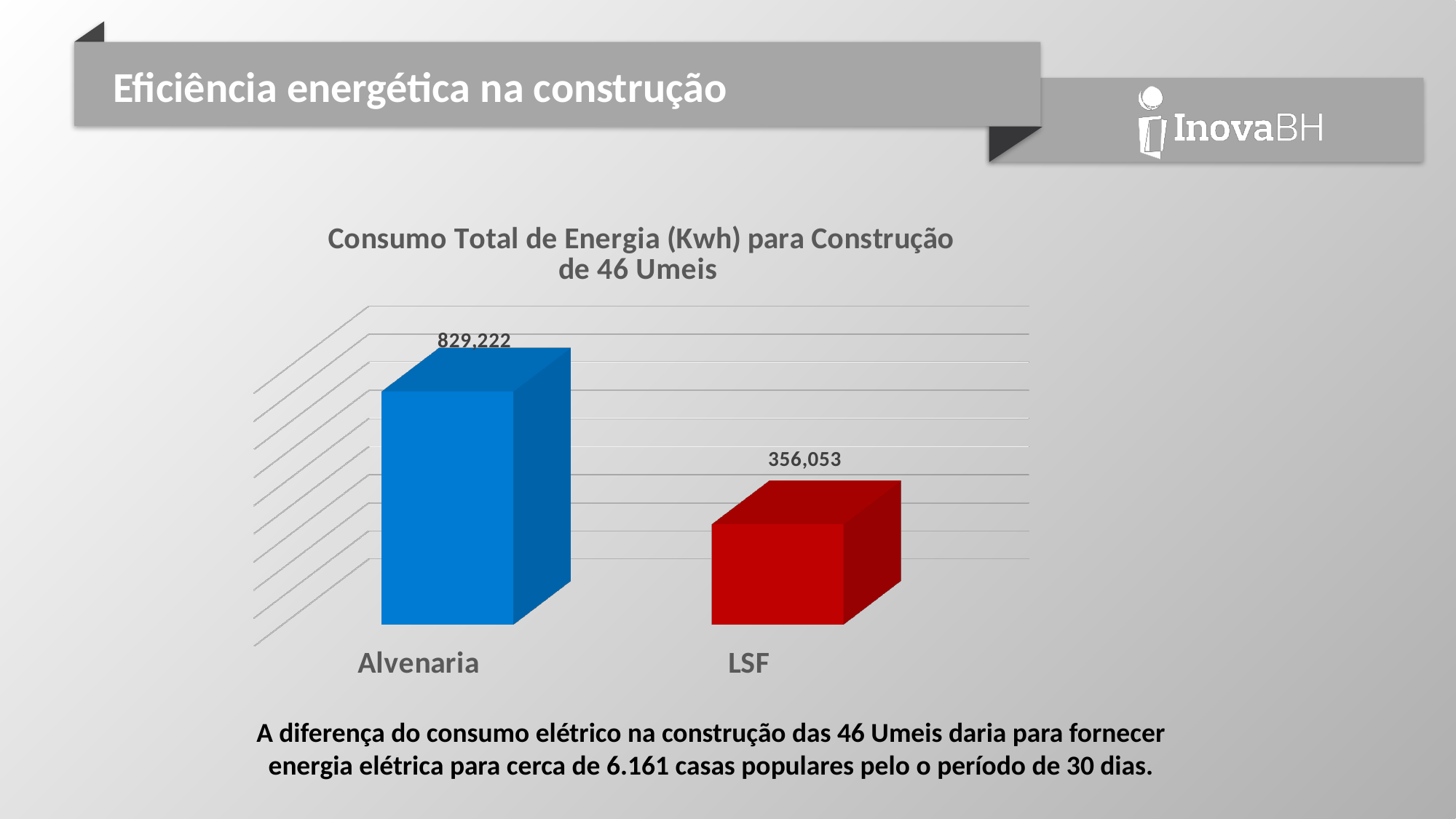
What colour is the bar for LSF? Red What is the difference between the values for Alvenaria and LSF? 473,169 What is the value for LSF? 356,053 What is the title of the chart? Consumo Total de Energia (Kwh) para Construção de 46 Umeis Which is larger, the value for Alvenaria or the value for LSF? Alvenaria Do the values rise or fall from Alvenaria to LSF? Fall What kind of chart is shown on the slide? Bar chart Which category has the highest value? Alvenaria What is the value for Alvenaria? 829,222 Which category has the lowest value? LSF How many categories are shown in the chart? 2